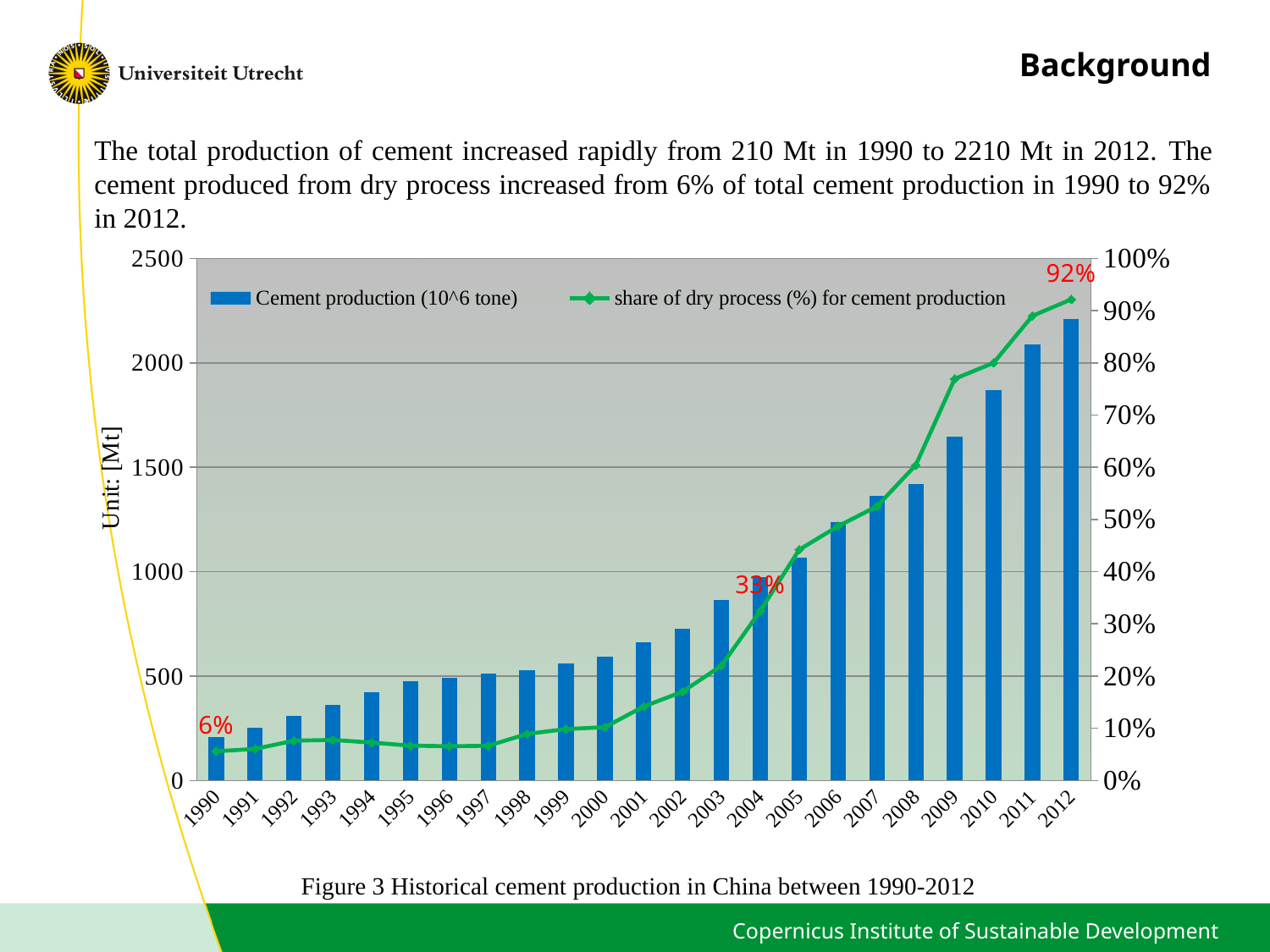
Does the share of dry process for cement production rise or fall from 1990 to 2012? rise How many series does the chart legend list? 2 What is the share of dry process for cement production in 1990? 6% Which year has the highest cement production? 2012 What kind of chart is shown on the slide? A combined bar and line chart By how many percentage points did the share of dry process increase from 1990 to 2012? 86% What is the share of dry process for cement production in 2012? 92% Is the cement production value for 2009 greater or less than 1500? greater What is the share of dry process for cement production in 2004? 33% Is the cement production value for 2008 greater or less than 1500? less Which year has the lowest cement production? 1990 How many years are shown along the x axis of the chart? 23